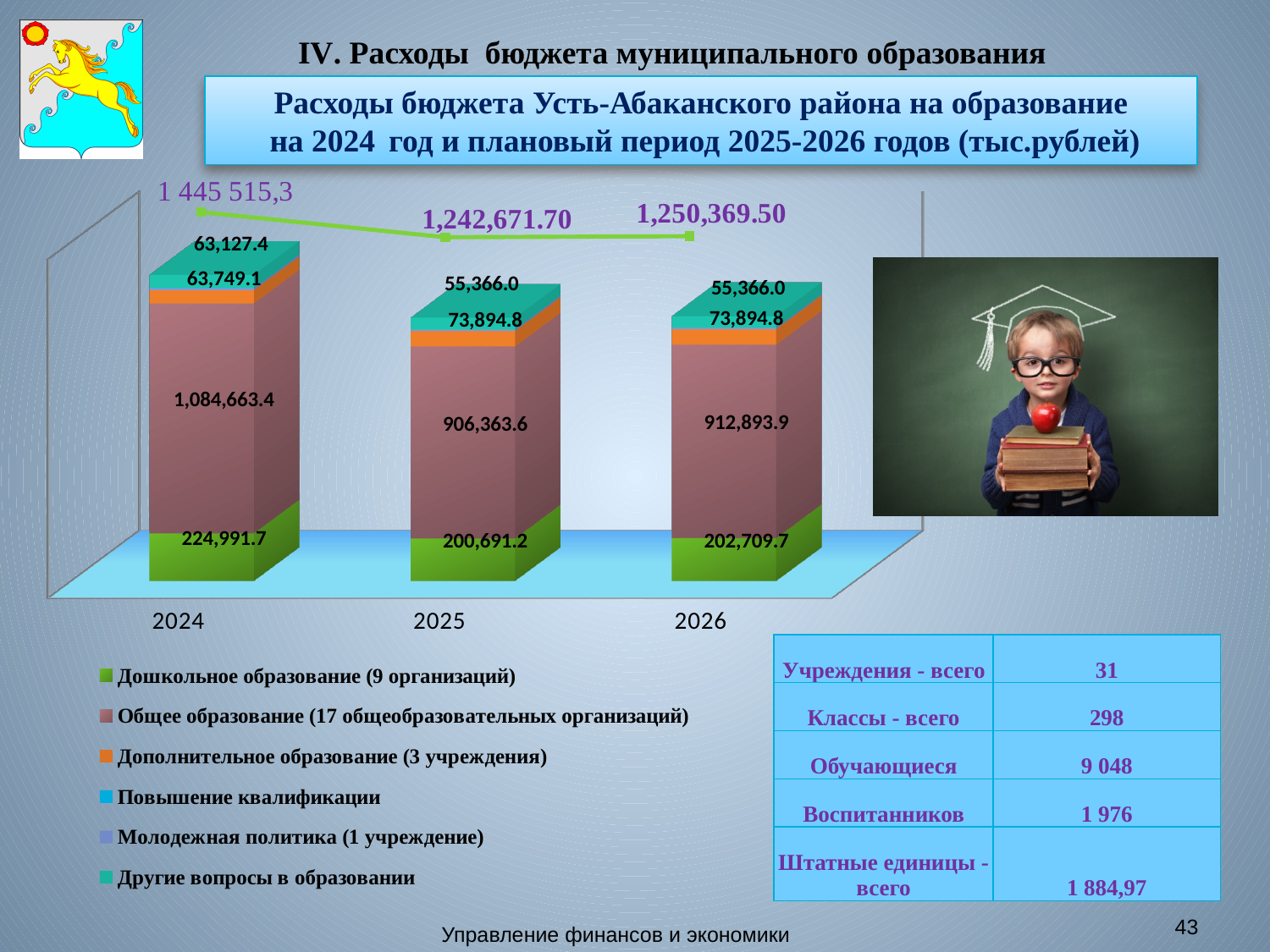
In which year is the value for Дошкольное образование the lowest? 2025 What is the value for Дошкольное образование in 2026? 202,709.7 Which year has the larger value for Общее образование, 2025 or 2026? 2026 How many years (categories) are shown on the x axis of the chart? 3 What kind of chart is shown on the slide? stacked bar chart What is the value for Общее образование in 2025? 906,363.6 What total value is shown by the line above the bar for 2025? 1,242,671.70 What is the difference between the Общее образование values for 2024 and 2025? 178,299.8 In which year is the value for Общее образование the highest? 2024 What is the value for Дошкольное образование in 2024? 224,991.7 How many series does the chart legend list? 6 What is the value for Общее образование in 2026? 912,893.9